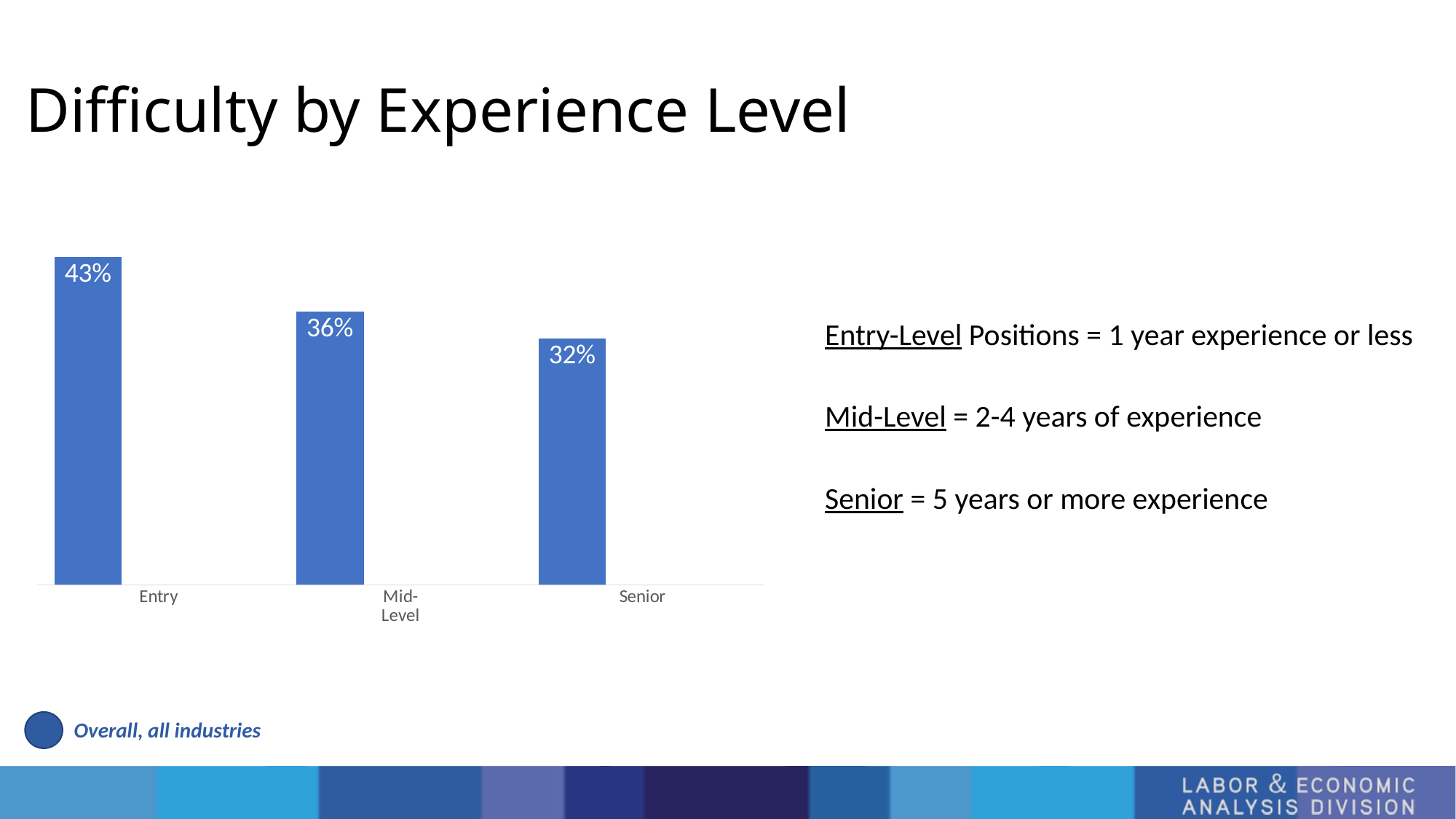
Which experience level has the lowest value? Senior What is the value for Mid-Level? 36% How many experience levels are shown in the chart? 3 What kind of chart is shown on the slide? Bar chart What is the value for Entry? 43% Do the values rise or fall from Entry to Senior? Fall What is the title of the slide containing the chart? Difficulty by Experience Level Which experience level has the highest value? Entry What is the difference between the values for Entry and Senior? 11% Which is larger, the value for Mid-Level or the value for Senior? Mid-Level What is the difference between the values for Entry and Mid-Level? 7% What is the value for Senior? 32%